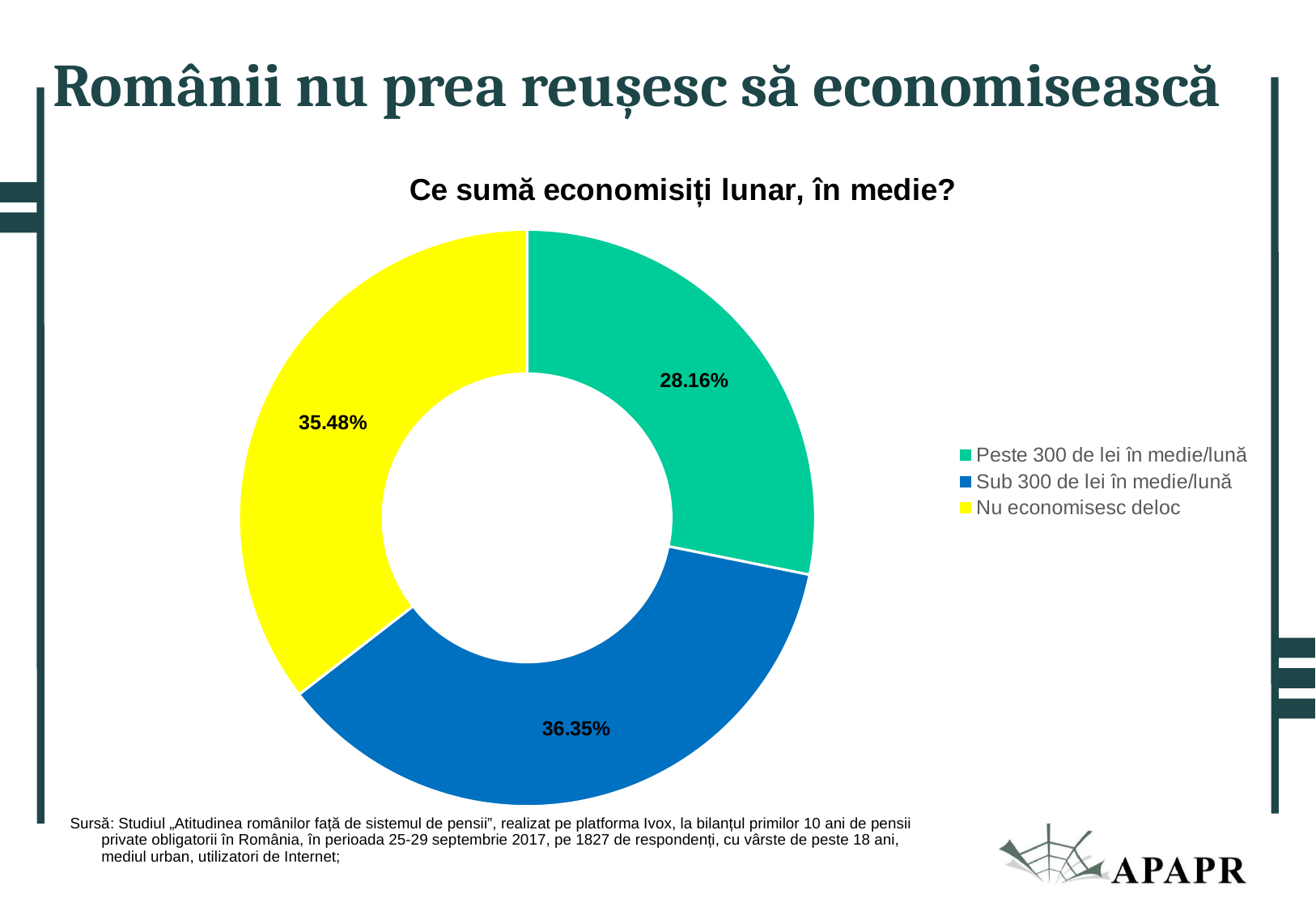
What percentage of respondents answered "Nu economisesc deloc"? 35.48% Which colour represents "Nu economisesc deloc" in the chart? Yellow What is the difference in percentage points between "Sub 300 de lei în medie/lună" and "Nu economisesc deloc"? 0.87 How many categories does the chart show? 3 What percentage of respondents save "Sub 300 de lei în medie/lună"? 36.35% What percentage of respondents save "Peste 300 de lei în medie/lună"? 28.16% What is the title of the chart? Ce sumă economisiți lunar, în medie? What kind of chart is shown on the slide? Pie chart (doughnut) Which is larger: the share for "Nu economisesc deloc" or the share for "Peste 300 de lei în medie/lună"? Nu economisesc deloc Which category has the largest share of the chart? Sub 300 de lei în medie/lună What is the difference in percentage points between "Sub 300 de lei în medie/lună" and "Peste 300 de lei în medie/lună"? 8.19 Which category has the smallest share of the chart? Peste 300 de lei în medie/lună